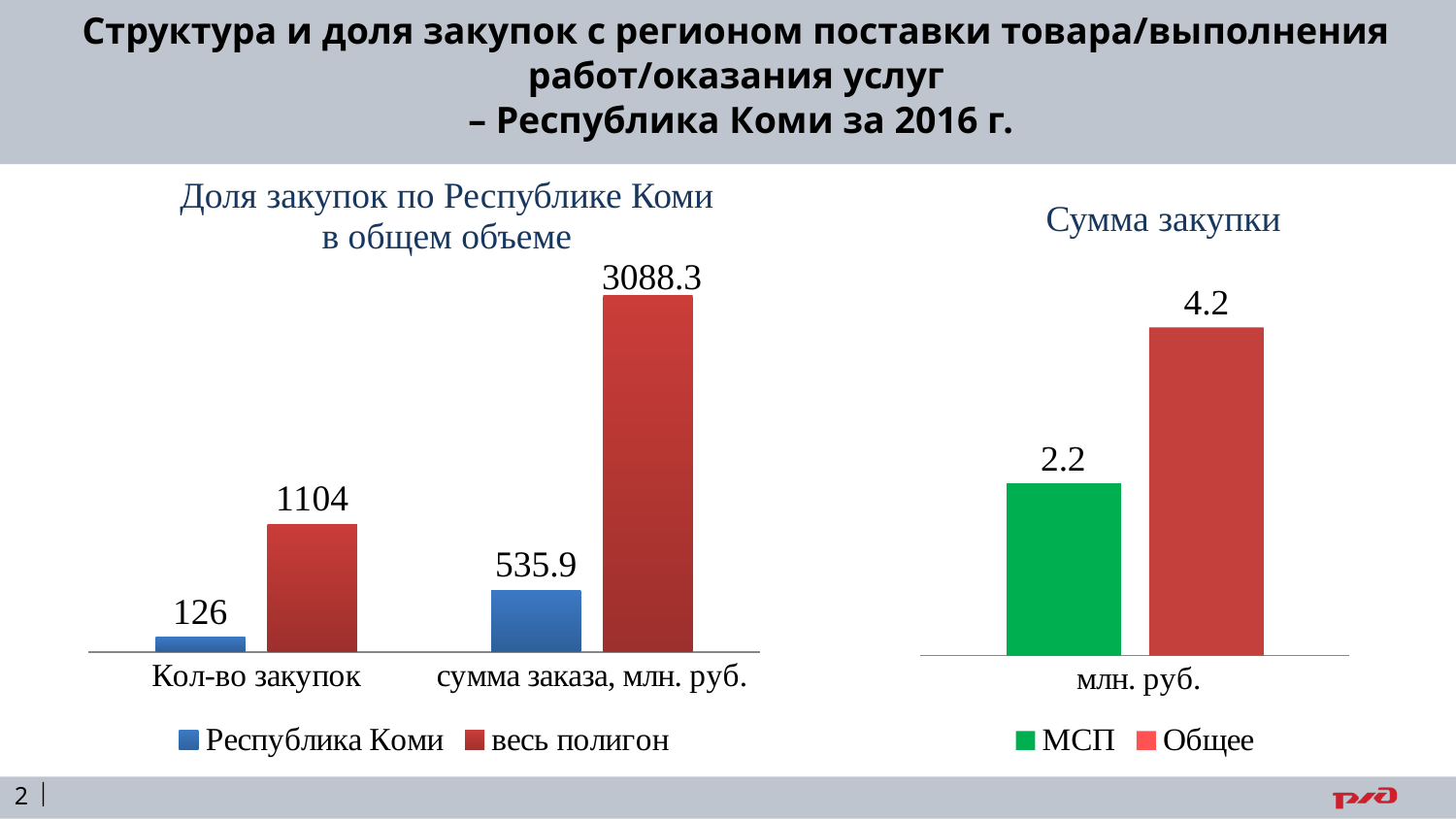
What kind of chart is the chart titled "Сумма закупки"? bar chart In the chart titled "Сумма закупки", what colour is the bar for "МСП"? green In the chart titled "Сумма закупки", what is the value for "МСП"? 2.2 In the chart titled "Сумма закупки", what is the difference between "Общее" and "МСП"? 2.0 In the chart titled "Доля закупок по Республике Коми в общем объеме", how many series does the legend list? 2 In the chart titled "Доля закупок по Республике Коми в общем объеме", what is the value for "весь полигон" in the "сумма заказа, млн. руб." category? 3088.3 In the chart titled "Сумма закупки", what is the value for "Общее"? 4.2 In the chart titled "Доля закупок по Республике Коми в общем объеме", how many categories are shown on the x axis? 2 In the chart titled "Доля закупок по Республике Коми в общем объеме", what is the value for "Республика Коми" in the "Кол-во закупок" category? 126 In the chart titled "Доля закупок по Республике Коми в общем объеме", what is the difference between "весь полигон" and "Республика Коми" in the "Кол-во закупок" category? 978 In the chart titled "Доля закупок по Республике Коми в общем объеме", which series has the larger value in the "сумма заказа, млн. руб." category? весь полигон In the chart titled "Доля закупок по Республике Коми в общем объеме", what is the value for "Республика Коми" in the "сумма заказа, млн. руб." category? 535.9